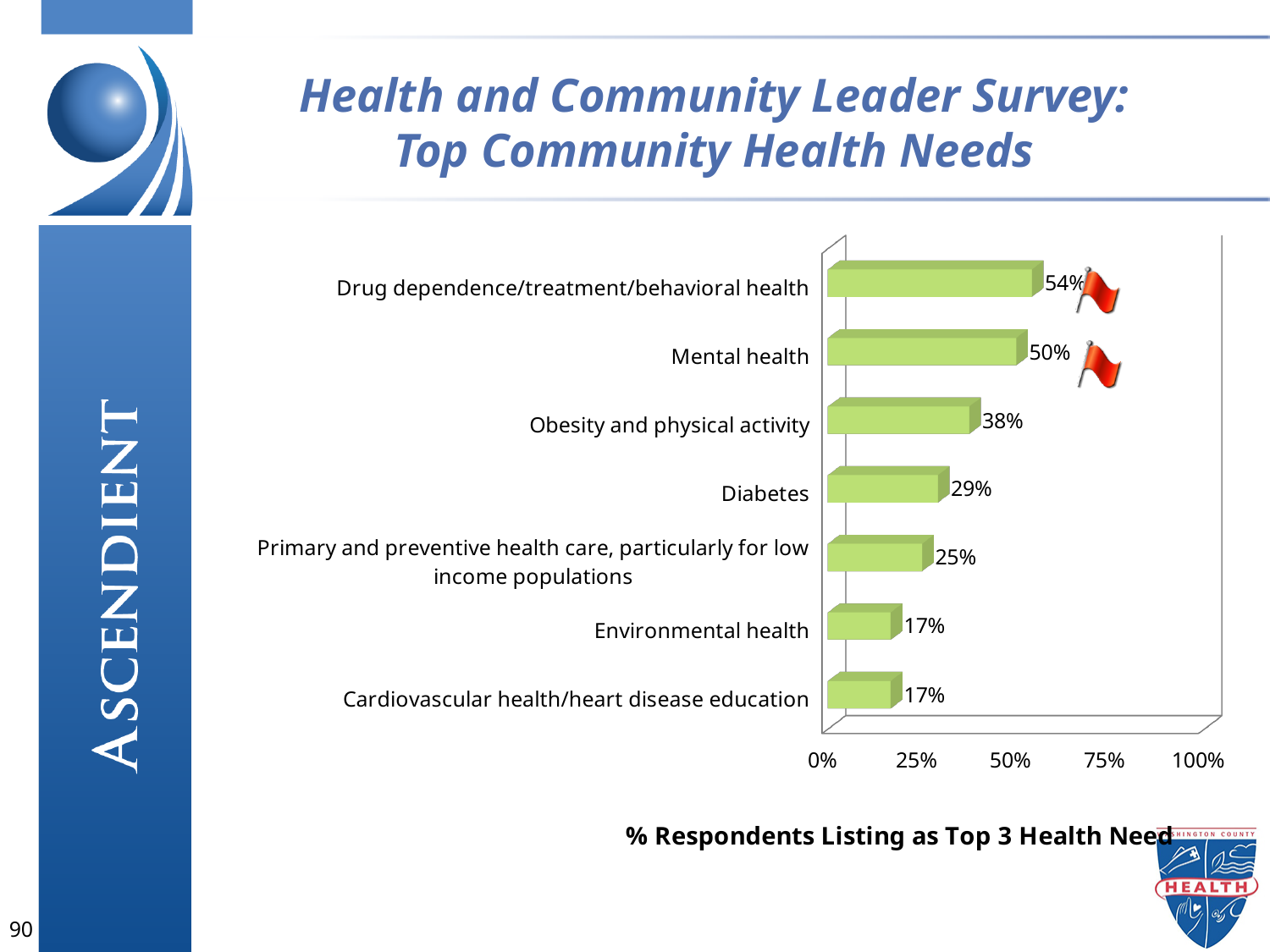
What is the difference between the values for Obesity and physical activity and Diabetes? 9% Which has a higher value, Diabetes or Environmental health? Diabetes What is the value shown for Mental health? 50% What percentage is shown for Obesity and physical activity? 38% What is the value for Diabetes? 29% What percentage is shown for Primary and preventive health care, particularly for low income populations? 25% How many categories are shown in the chart? 7 What is the difference in percentage points between Drug dependence/treatment/behavioral health and Mental health? 4% What is the label shown below the chart's horizontal axis? % Respondents Listing as Top 3 Health Need What type of chart is shown on the slide? Bar chart Which category has the highest percentage of respondents listing it as a top 3 health need? Drug dependence/treatment/behavioral health What percentage of respondents listed Drug dependence/treatment/behavioral health as a top 3 health need? 54%